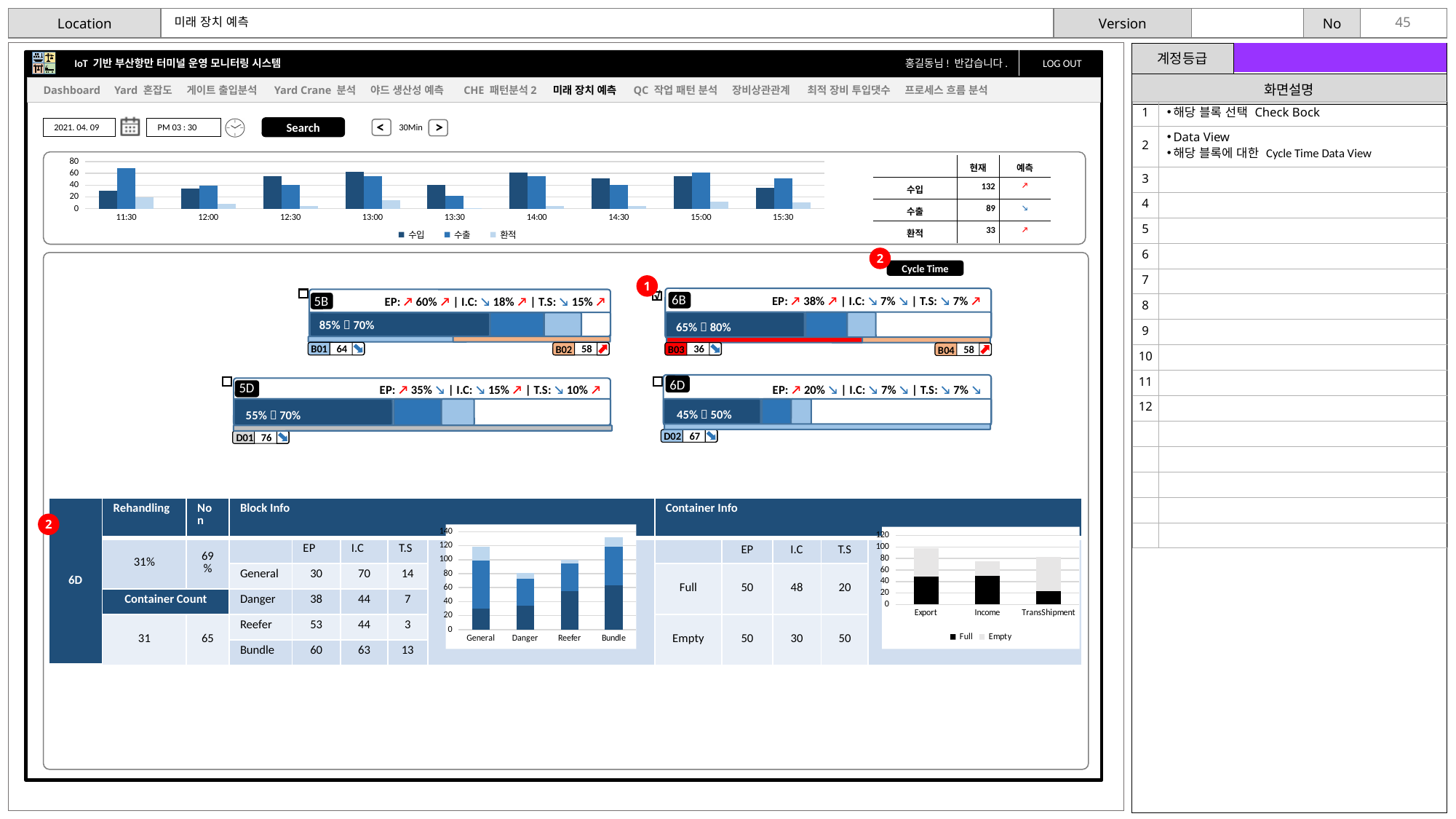
In the Block Info chart, which category has the shortest stacked bar? Danger In the Container Info chart, how many series does the legend list? 2 In the top chart (11:30 to 15:30), what are the legend entries? 수입, 수출, 환적 In the Container Info chart, which category has the tallest stacked bar? Export In the top chart (11:30 to 15:30), is the value for 환적 at 12:30 greater or less than 20? less In the Block Info chart, is the total for Bundle greater or less than 120? greater In the top chart (11:30 to 15:30), how many series does the legend list? 3 What kind of chart is the chart at the top of the slide showing times from 11:30 to 15:30? bar chart In the Block Info chart, how many categories are shown on the x axis? 4 In the top chart (11:30 to 15:30), how many time categories are shown on the x axis? 9 In the Block Info chart, which category has the tallest stacked bar? Bundle In the top chart (11:30 to 15:30), is the value for 수입 at 11:30 greater or less than 60? less